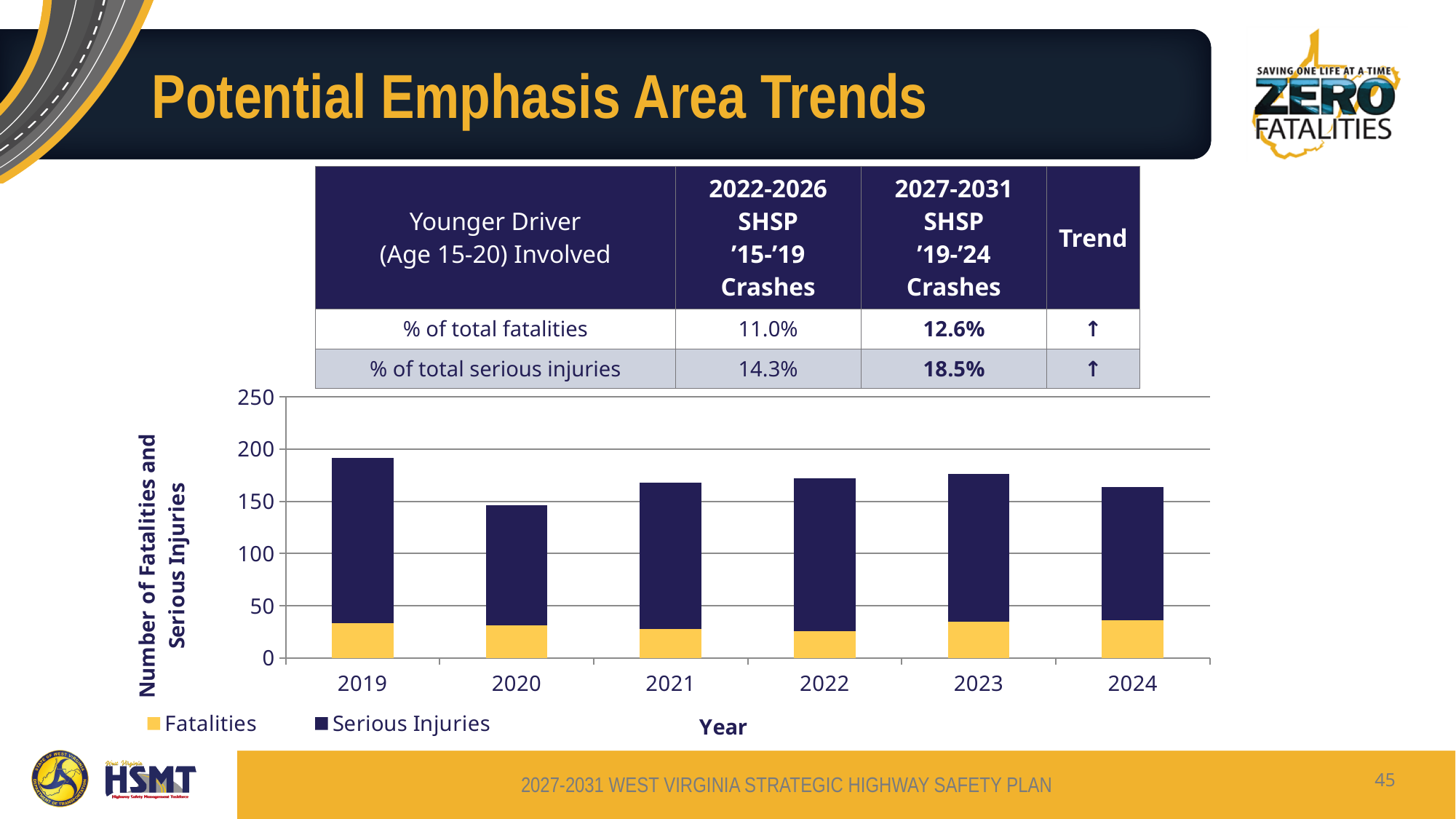
Did the total bar height rise or fall from 2019 to 2020? fall Which series is shown in yellow in the chart legend? Fatalities How many series does the chart legend list? 2 How many years are shown on the x axis of the chart? 6 Is the Fatalities portion of the 2022 bar greater or less than 50? less Which year has a taller stacked bar, 2019 or 2020? 2019 Is the total bar height for 2019 greater or less than 150? greater Is the total bar height for 2024 greater or less than 150? greater What kind of chart is shown on the slide? Stacked bar chart Which year has the shortest stacked bar in the chart? 2020 Which year has the tallest stacked bar in the chart? 2019